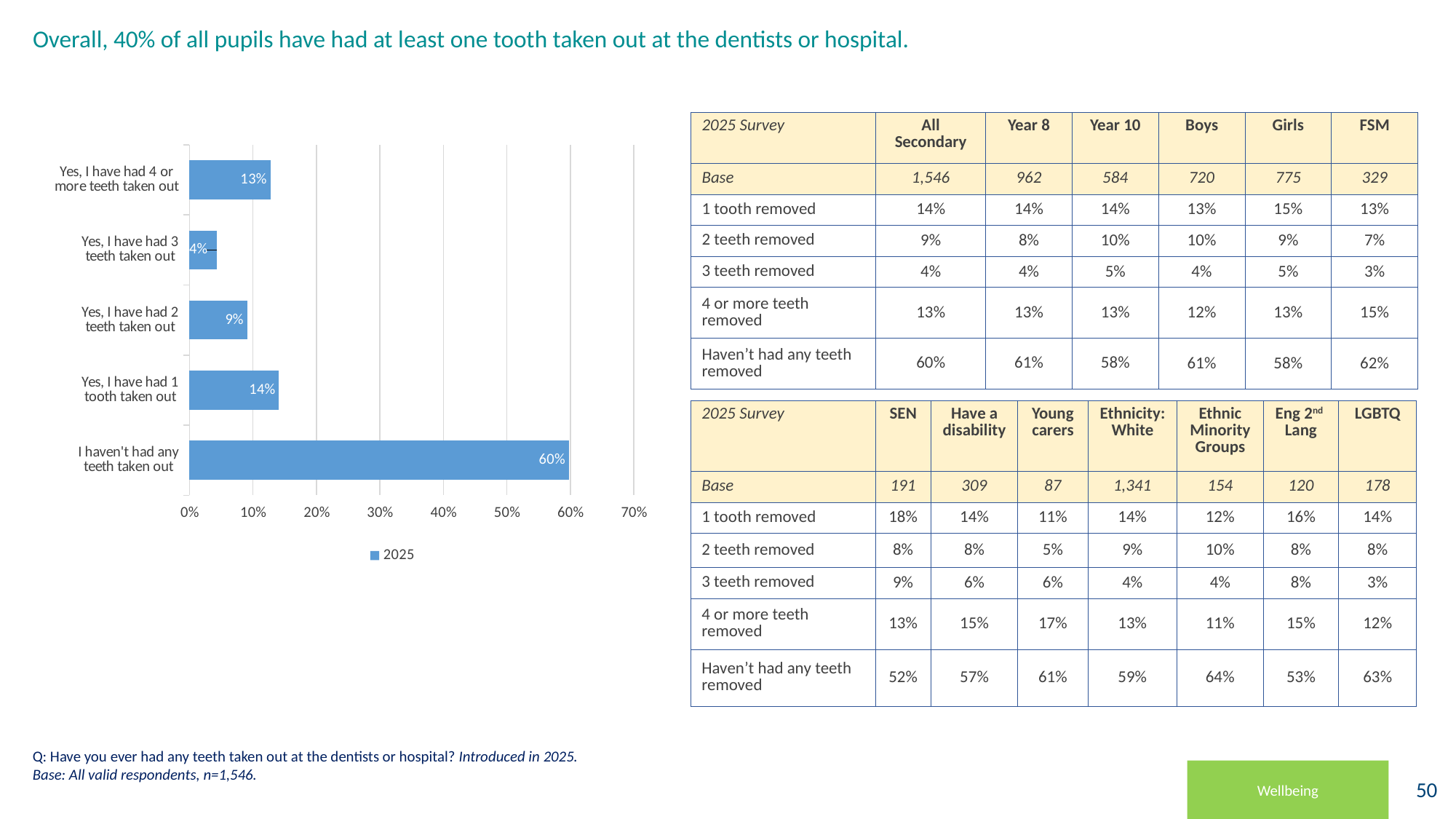
What type of chart is shown on the slide? Bar chart Is the value for 'I haven't had any teeth taken out' greater or less than 50%? greater What percentage of pupils have had 1 tooth taken out? 14% What percentage of pupils have had 3 teeth taken out? 4% How many series does the chart legend list? 1 What percentage of pupils have had 4 or more teeth taken out? 13% What is the difference between the percentage who have had 1 tooth taken out and the percentage who have had 2 teeth taken out? 5% Which is larger: the percentage who have had 4 or more teeth taken out or the percentage who have had 2 teeth taken out? 4 or more teeth taken out Which category has the highest value in the bar chart? I haven't had any teeth taken out Which category has the lowest value in the bar chart? Yes, I have had 3 teeth taken out What percentage of pupils said they haven't had any teeth taken out? 60% How many categories are shown in the bar chart? 5